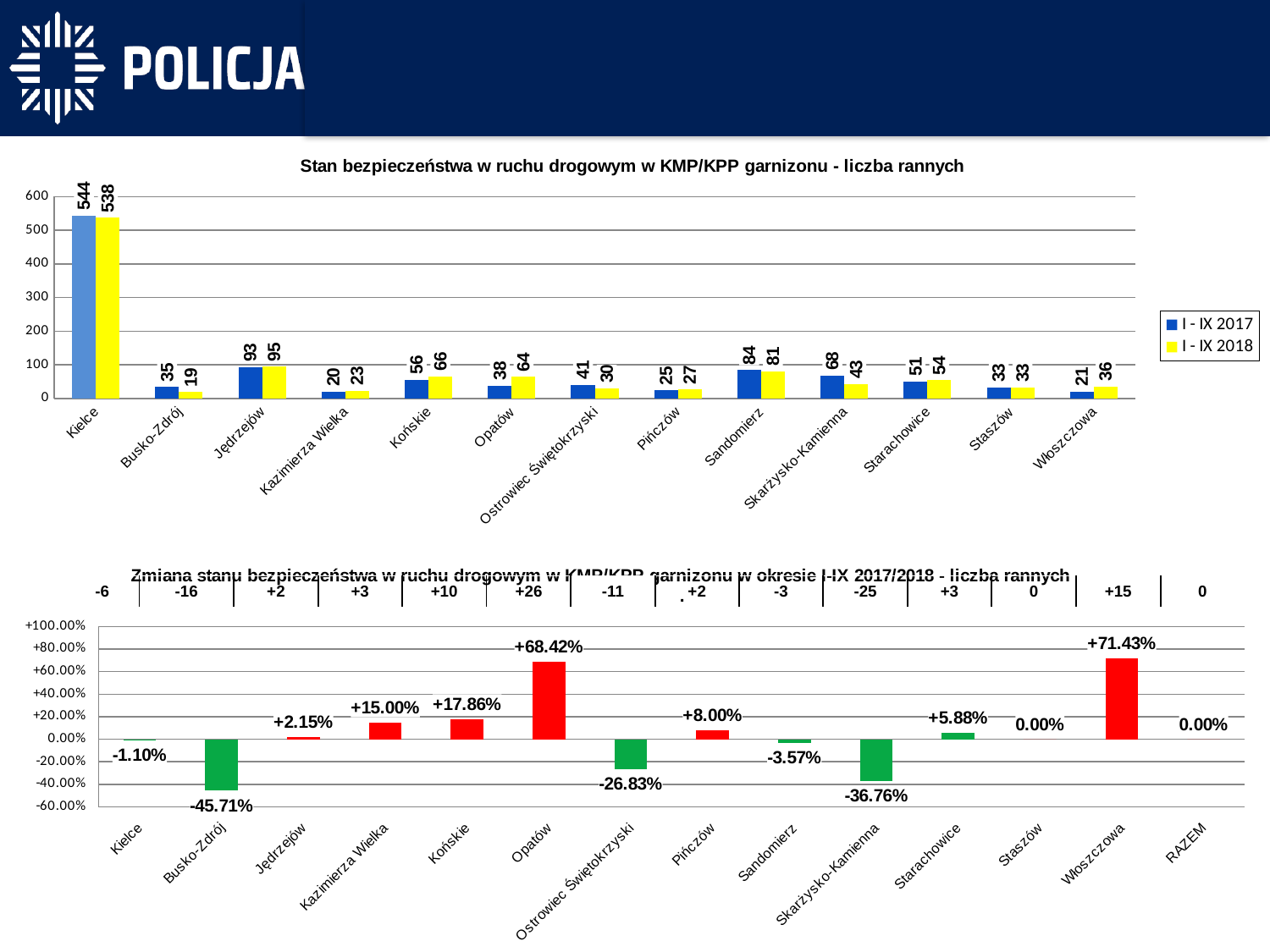
In the top chart (liczba rannych), which category has the lowest value in I - IX 2018? Busko-Zdrój In the bottom chart (Zmiana stanu bezpieczeństwa), which category has the highest value? Włoszczowa In the bottom chart (Zmiana stanu bezpieczeństwa), which category has the lowest value? Busko-Zdrój In the top chart (liczba rannych), what is the value for Kielce in I - IX 2018? 538 How many categories are shown on the x axis of the top chart (liczba rannych)? 13 How many series does the legend of the top chart (liczba rannych) list? 2 What kind of chart is the bottom chart (Zmiana stanu bezpieczeństwa)? bar chart In the top chart (liczba rannych), what is the difference between the I - IX 2017 and I - IX 2018 values for Skarżysko-Kamienna? 25 In the top chart (liczba rannych), which category has the highest value in I - IX 2017? Kielce In the top chart (liczba rannych), what is the value for Opatów in I - IX 2017? 38 In the top chart (liczba rannych), which is larger for Włoszczowa: I - IX 2017 or I - IX 2018? I - IX 2018 In the bottom chart (Zmiana stanu bezpieczeństwa), what is the value for Opatów? +68.42%